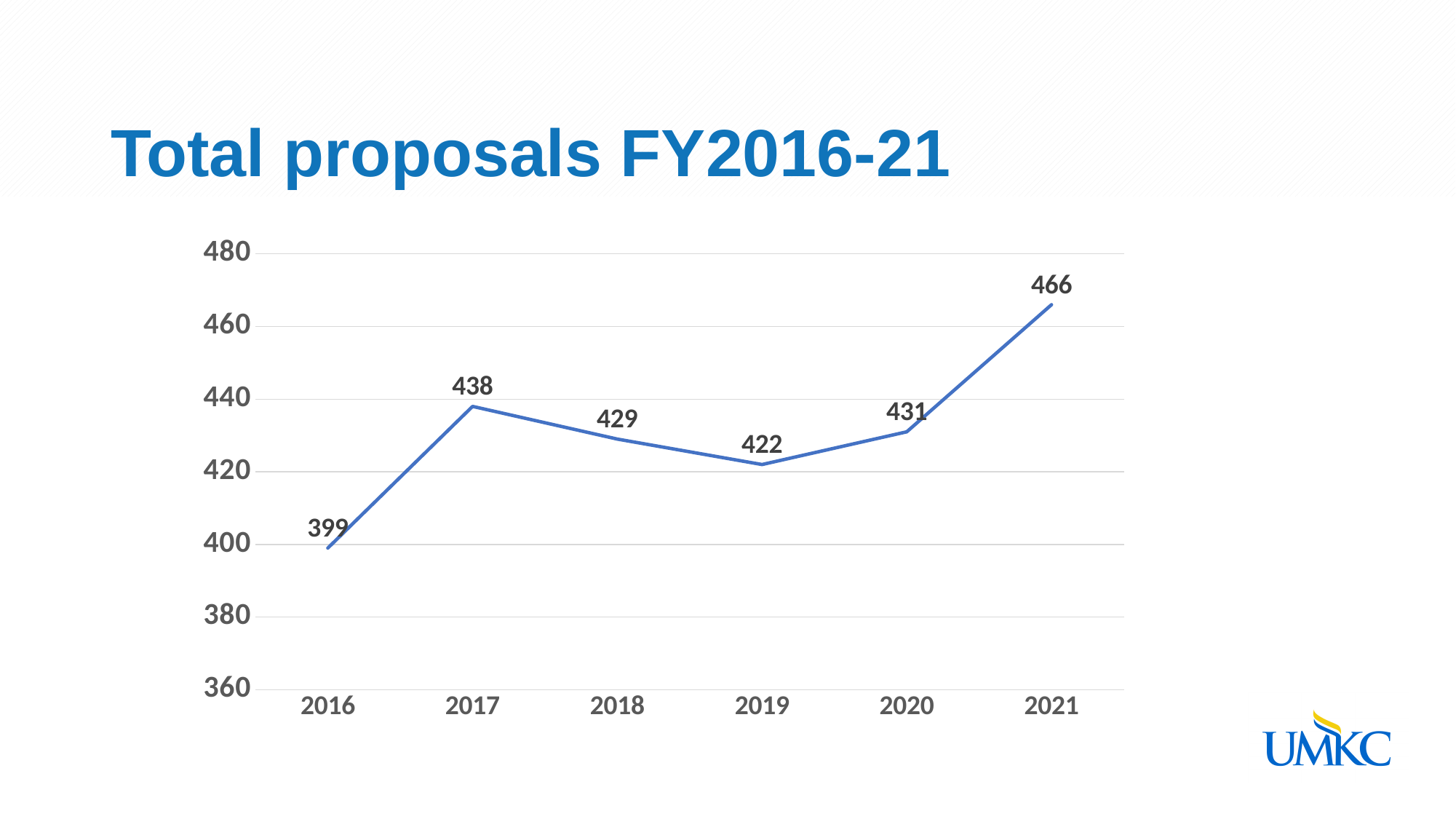
What is the difference between the values for 2017 and 2018? 9 Which year has the lowest value? 2016 What is the difference between the values for 2021 and 2016? 67 What is the value for 2019? 422 Which is larger, the value for 2017 or the value for 2020? 2017 What is the value for 2021? 466 What is the title of the slide? Total proposals FY2016-21 What is the value for 2016? 399 How many years are plotted on the chart? 6 Which year has the highest value? 2021 What kind of chart is shown on the slide? line chart Is the value for 2018 greater or less than 420? greater